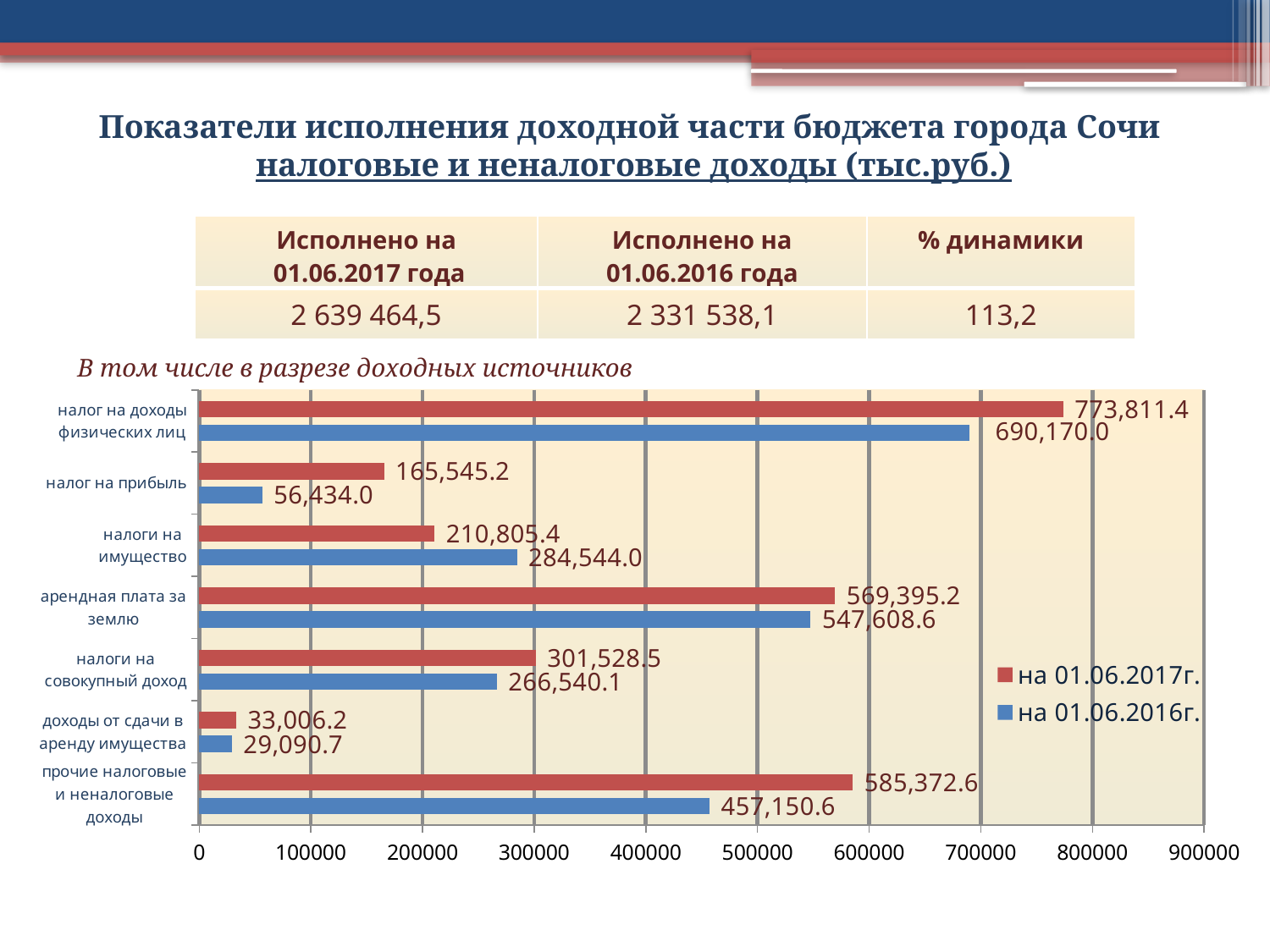
How many series does the chart legend list? 2 Which colour represents the series 'на 01.06.2017г.' in the chart? red Which category has the lowest value in the series 'на 01.06.2017г.'? доходы от сдачи в аренду имущества What is the value for 'прочие налоговые и неналоговые доходы' in the series 'на 01.06.2017г.'? 585,372.6 What type of chart is shown on the slide? bar chart What is the value for 'налог на доходы физических лиц' in the series 'на 01.06.2017г.'? 773,811.4 For 'налоги на имущество', which series has the larger value: 'на 01.06.2017г.' or 'на 01.06.2016г.'? на 01.06.2016г. What is the value for 'налог на прибыль' in the series 'на 01.06.2016г.'? 56,434.0 Which category has the highest value in the series 'на 01.06.2016г.'? налог на доходы физических лиц What is the difference between the 'на 01.06.2017г.' and 'на 01.06.2016г.' values for 'налог на доходы физических лиц'? 83,641.4 How many categories are shown on the chart? 7 Is the value for 'арендная плата за землю' in the series 'на 01.06.2016г.' greater or less than 500000? greater